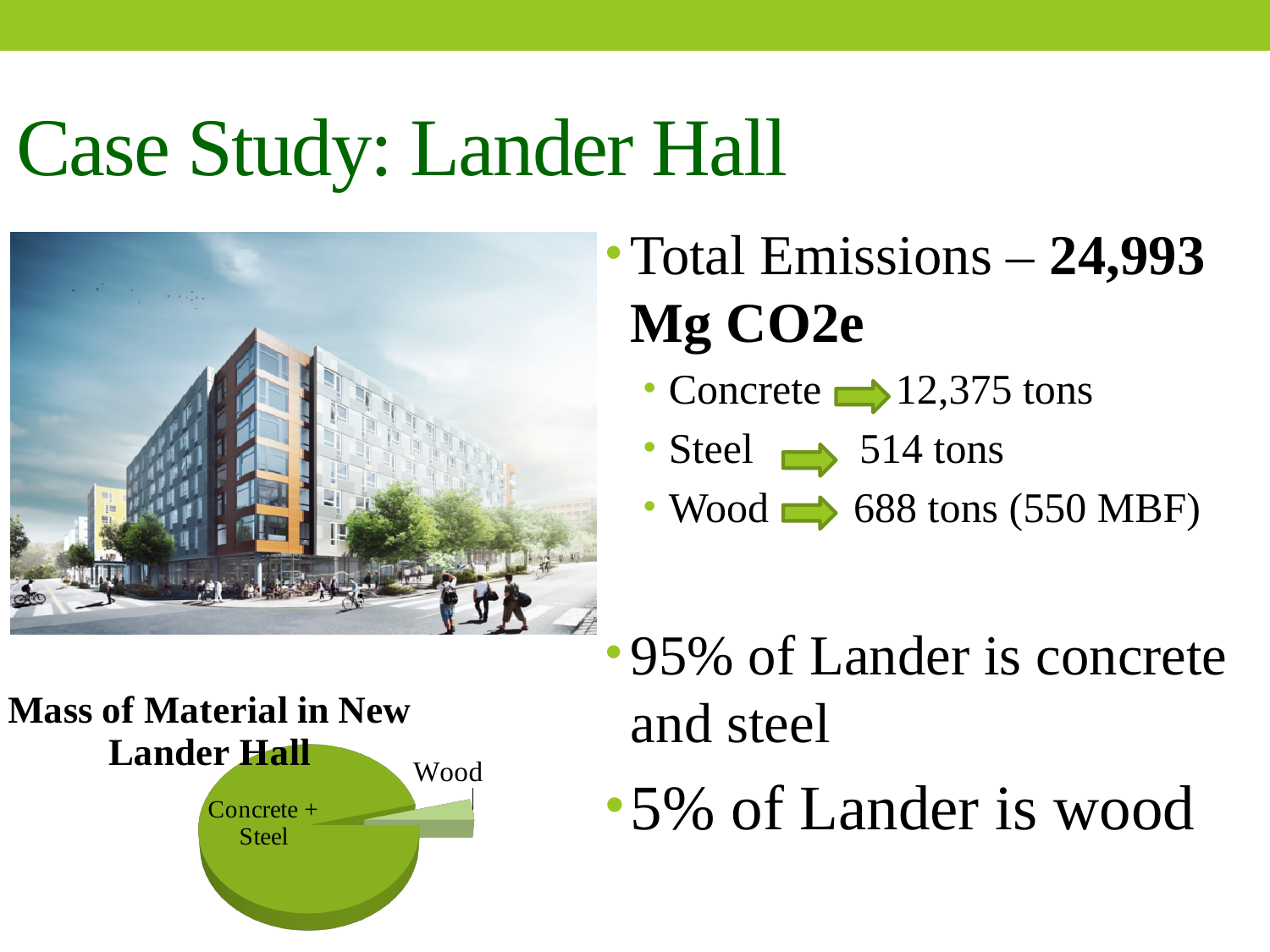
How many slices does the pie chart have? 2 What is the title of the pie chart? Mass of Material in New Lander Hall What are the two categories labelled on the pie chart? Concrete + Steel and Wood Which slice is pulled out (exploded) from the pie chart? Wood What kind of chart is shown on the slide? Pie chart Which slice of the pie chart is the smallest? Wood Which slice of the pie chart is the largest? Concrete + Steel Which is larger in the pie chart, the Concrete + Steel slice or the Wood slice? Concrete + Steel